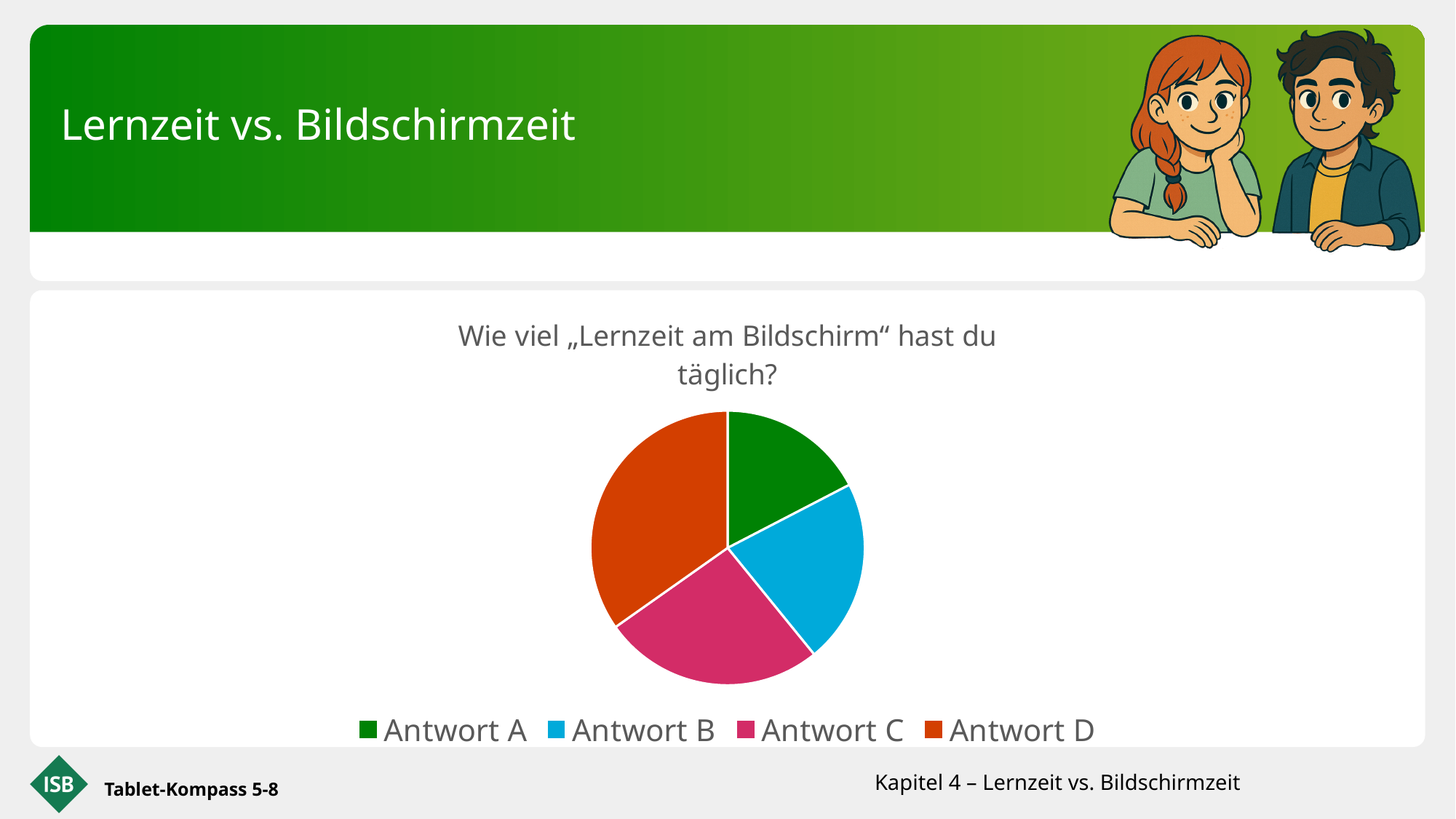
Which slice is larger, Antwort D or Antwort B? Antwort D Which answer has the smallest slice of the pie? Antwort A Which slice is larger, Antwort C or Antwort A? Antwort C What colour is the slice for Antwort B? blue What is the title of the chart? Wie viel „Lernzeit am Bildschirm“ hast du täglich? Which slice is larger, Antwort D or Antwort A? Antwort D Which answer has the largest slice of the pie? Antwort D How many slices does the pie chart have? 4 What kind of chart is shown on the slide? pie chart How many entries does the chart legend list? 4